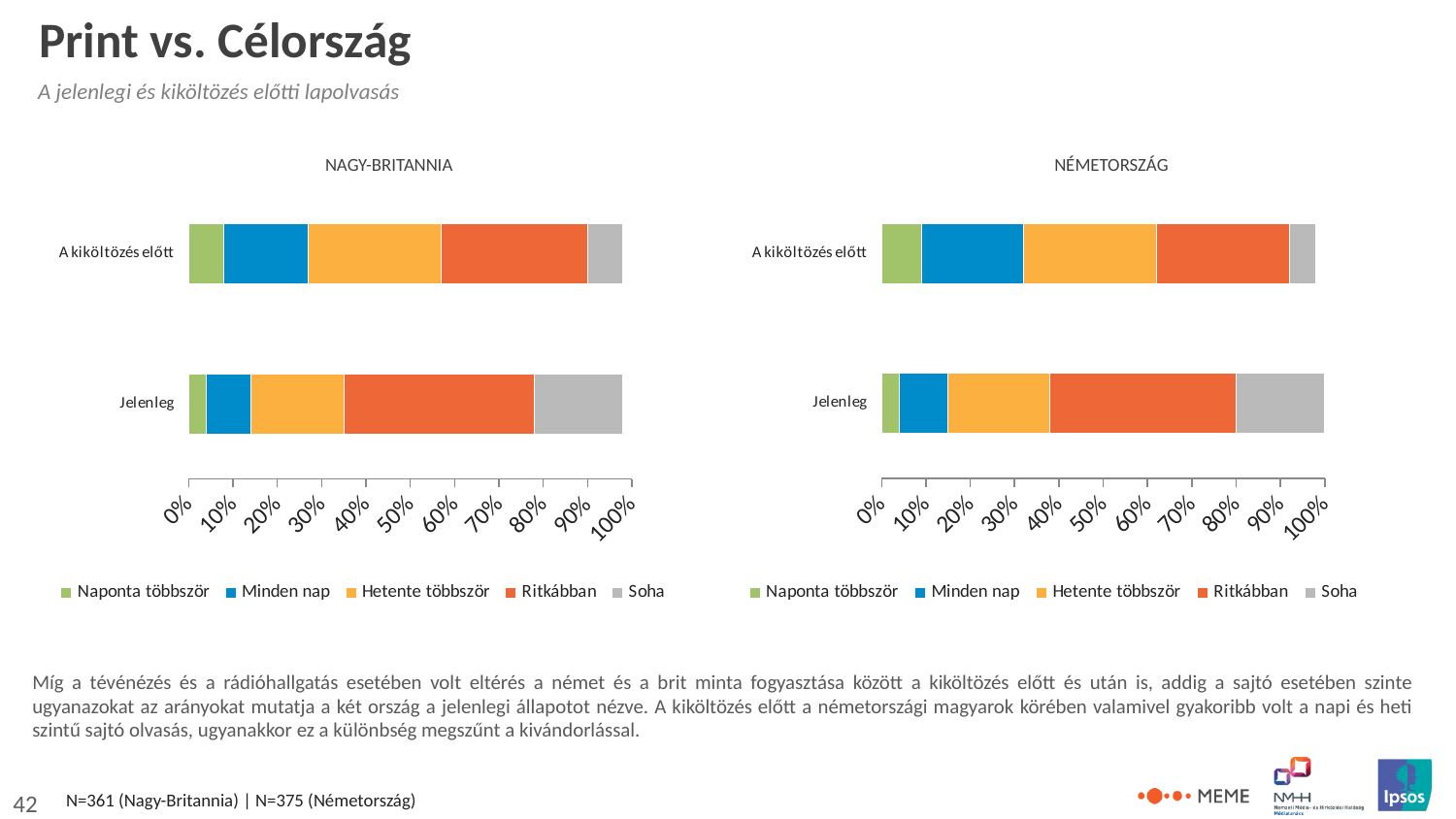
How many series does the legend of the NÉMETORSZÁG chart list? 5 In the NAGY-BRITANNIA chart, which series has the largest segment in the Jelenleg bar? Ritkábban In the NÉMETORSZÁG chart, is the Minden nap value for A kiköltözés előtt greater or less than 10%? greater What is the title of the chart on the right side of the slide? NÉMETORSZÁG In the NAGY-BRITANNIA chart, is the Soha value for A kiköltözés előtt greater or less than 20%? less In the NAGY-BRITANNIA chart, is the Soha share larger for Jelenleg or for A kiköltözés előtt? Jelenleg In the NÉMETORSZÁG chart, is the Ritkábban value for Jelenleg greater or less than 30%? greater In the NAGY-BRITANNIA chart, which series is shown in green in the legend? Naponta többször How many categories (bars) are shown in the NAGY-BRITANNIA chart? 2 What kind of chart is the NAGY-BRITANNIA chart? Stacked bar chart In the NÉMETORSZÁG chart, is the Ritkábban share larger for Jelenleg or for A kiköltözés előtt? Jelenleg